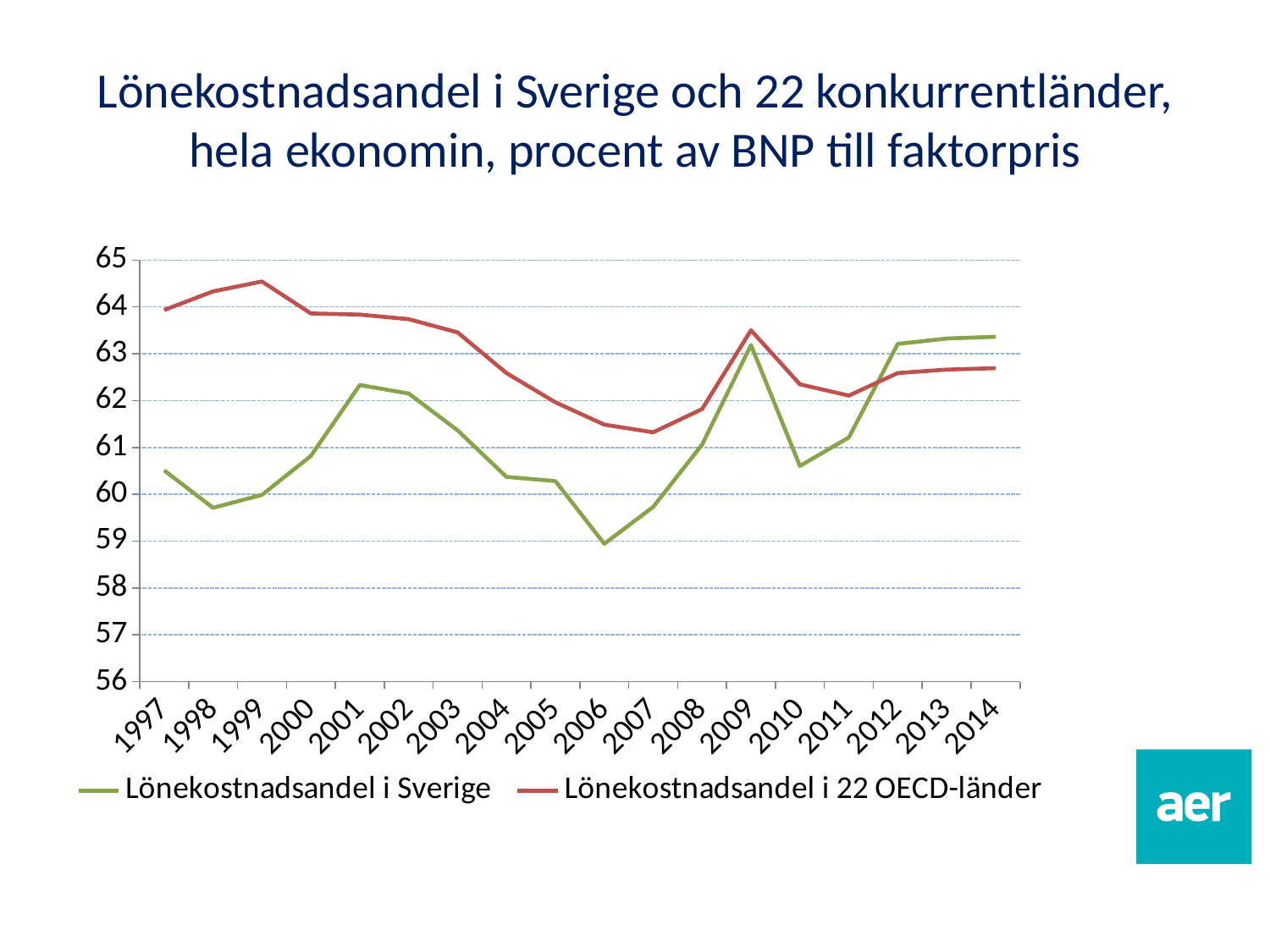
In which year is the value for Lönekostnadsandel i 22 OECD-länder lowest? 2007 Is the value for Lönekostnadsandel i Sverige in 2001 greater or less than 62? greater In which year is the value for Lönekostnadsandel i Sverige lowest? 2006 In which year is the value for Lönekostnadsandel i 22 OECD-länder highest? 1999 How many series does the legend list? 2 In 1997, which series has the higher value, Lönekostnadsandel i Sverige or Lönekostnadsandel i 22 OECD-länder? Lönekostnadsandel i 22 OECD-länder Does the value for Lönekostnadsandel i 22 OECD-länder rise or fall from 1999 to 2007? fall How many years are shown on the x axis? 18 What colour is the line for Lönekostnadsandel i Sverige? green What kind of chart is shown on the slide? line chart Is the value for Lönekostnadsandel i 22 OECD-länder in 1999 greater or less than 64? greater